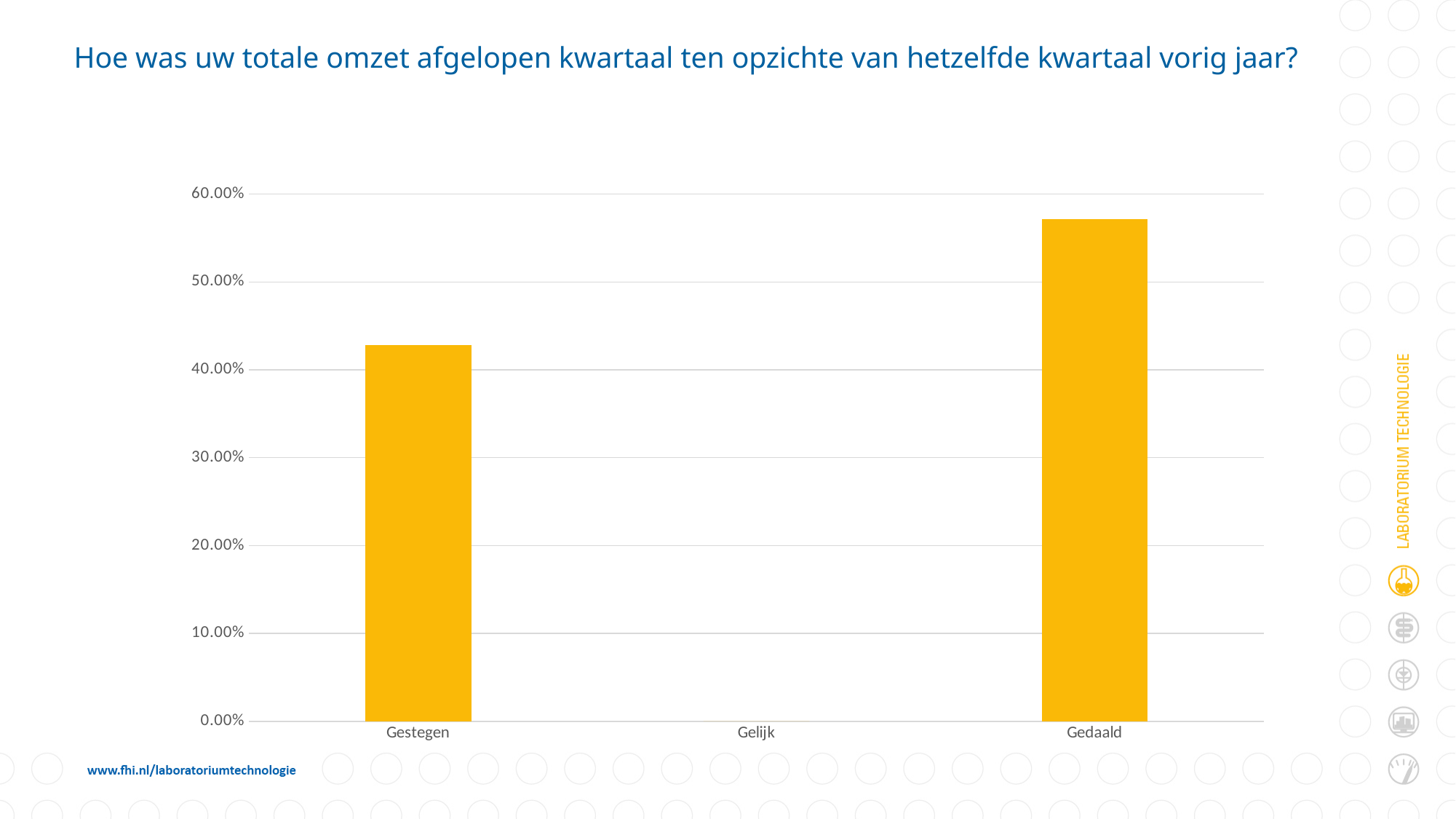
What colour are the bars in the chart? yellow Which is larger, the value for Gestegen or the value for Gedaald? Gedaald Is the value for Gestegen greater or less than 40.00%? greater Is the value for Gestegen greater or less than 50.00%? less Is the value for Gedaald greater or less than 50.00%? greater What is the title of the slide containing the chart? Hoe was uw totale omzet afgelopen kwartaal ten opzichte van hetzelfde kwartaal vorig jaar? What kind of chart is shown on the slide? bar chart Which category has the highest value in the chart? Gedaald How many categories are shown on the x axis of the chart? 3 Which category has the lowest value in the chart? Gelijk